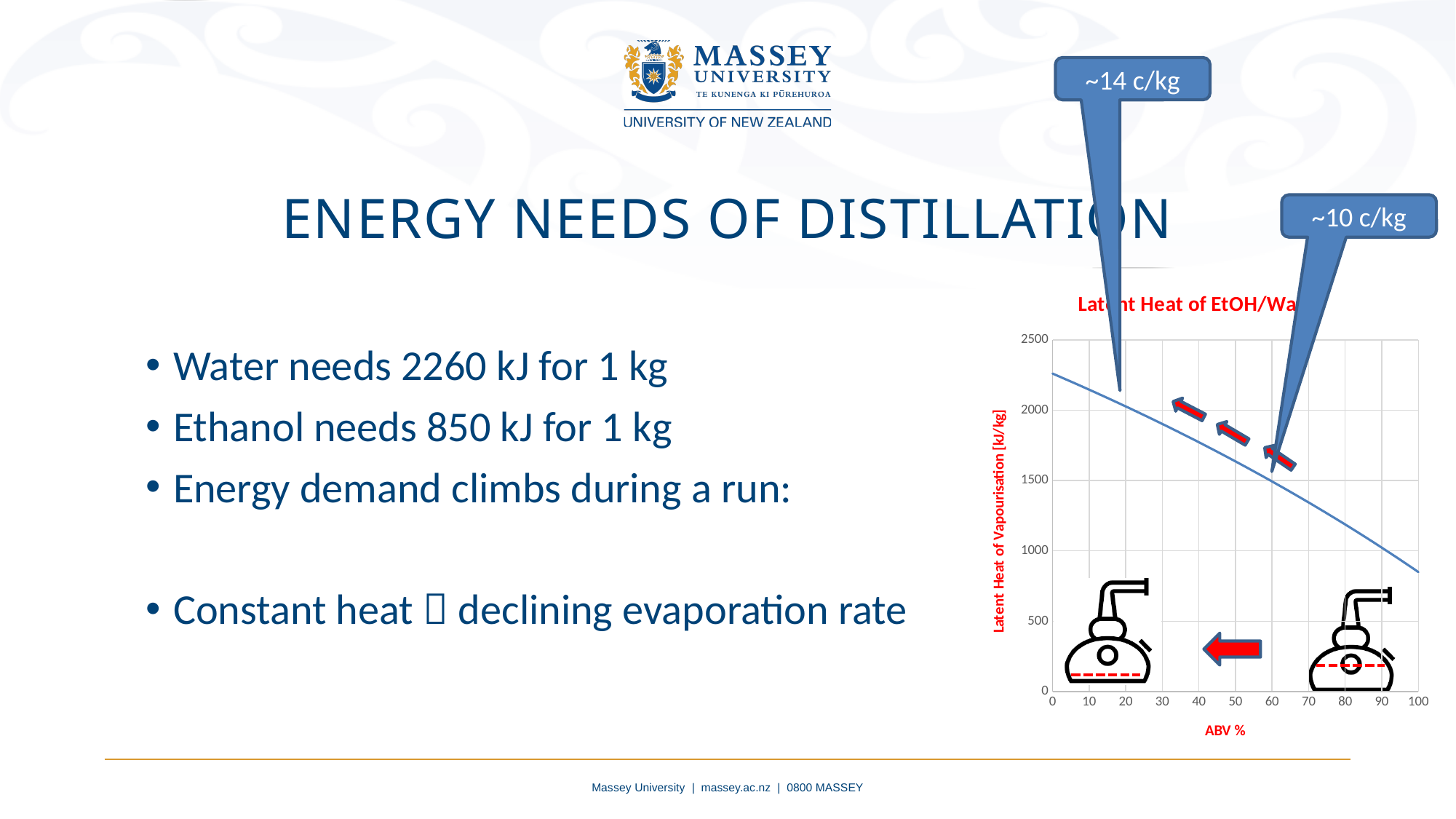
Which has the larger latent heat value on the chart, 0% ABV or 100% ABV? 0% ABV Is the latent heat value at 30% ABV greater or less than 1500? greater What is the label of the x axis of the chart? ABV % What kind of chart is shown on the slide? line chart What is the label of the y axis of the chart? Latent Heat of Vapourisation [kJ/kg] Do the values on the chart rise or fall as ABV % increases? fall Is the latent heat value at 10% ABV greater or less than 2500? less What is the highest tick value shown on the y axis of the chart? 2500 Is the latent heat value at 100% ABV greater or less than 1000? less